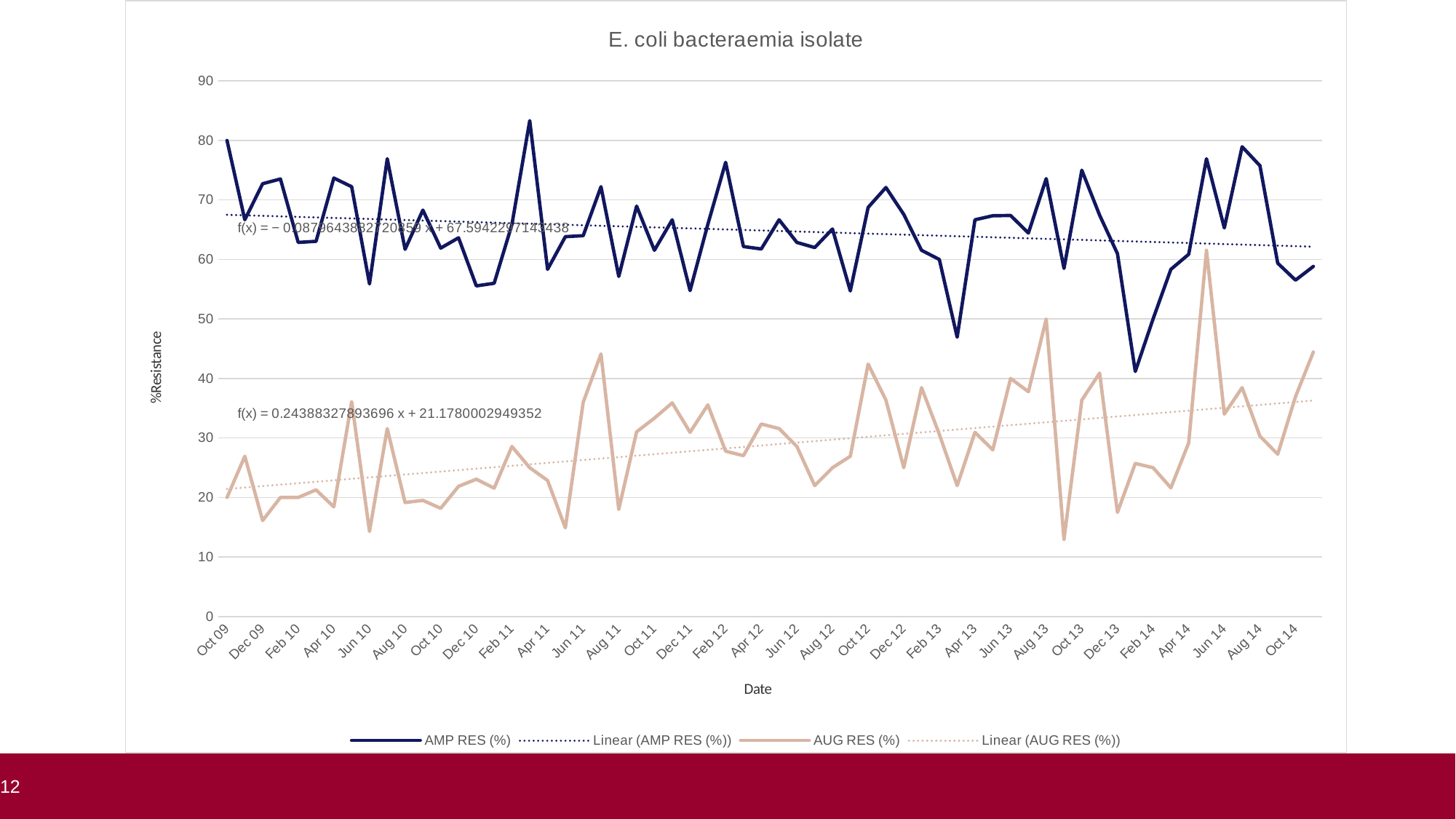
Which series has the higher value at Oct 09, AMP RES (%) or AUG RES (%)? AMP RES (%) Does the Linear (AMP RES (%)) trend line rise or fall from Oct 09 to Oct 14? fall Is the AUG RES (%) value at Oct 13 greater or less than 20? greater How many entries does the chart legend list? 4 Is the AMP RES (%) value at Apr 11 greater or less than 80? less Is the AUG RES (%) value at Oct 09 greater or less than 30? less Does the Linear (AUG RES (%)) trend line rise or fall from Oct 09 to Oct 14? rise What is the label of the vertical axis? %Resistance What is the title of the chart? E. coli bacteraemia isolate What kind of chart is shown on the slide? Line chart